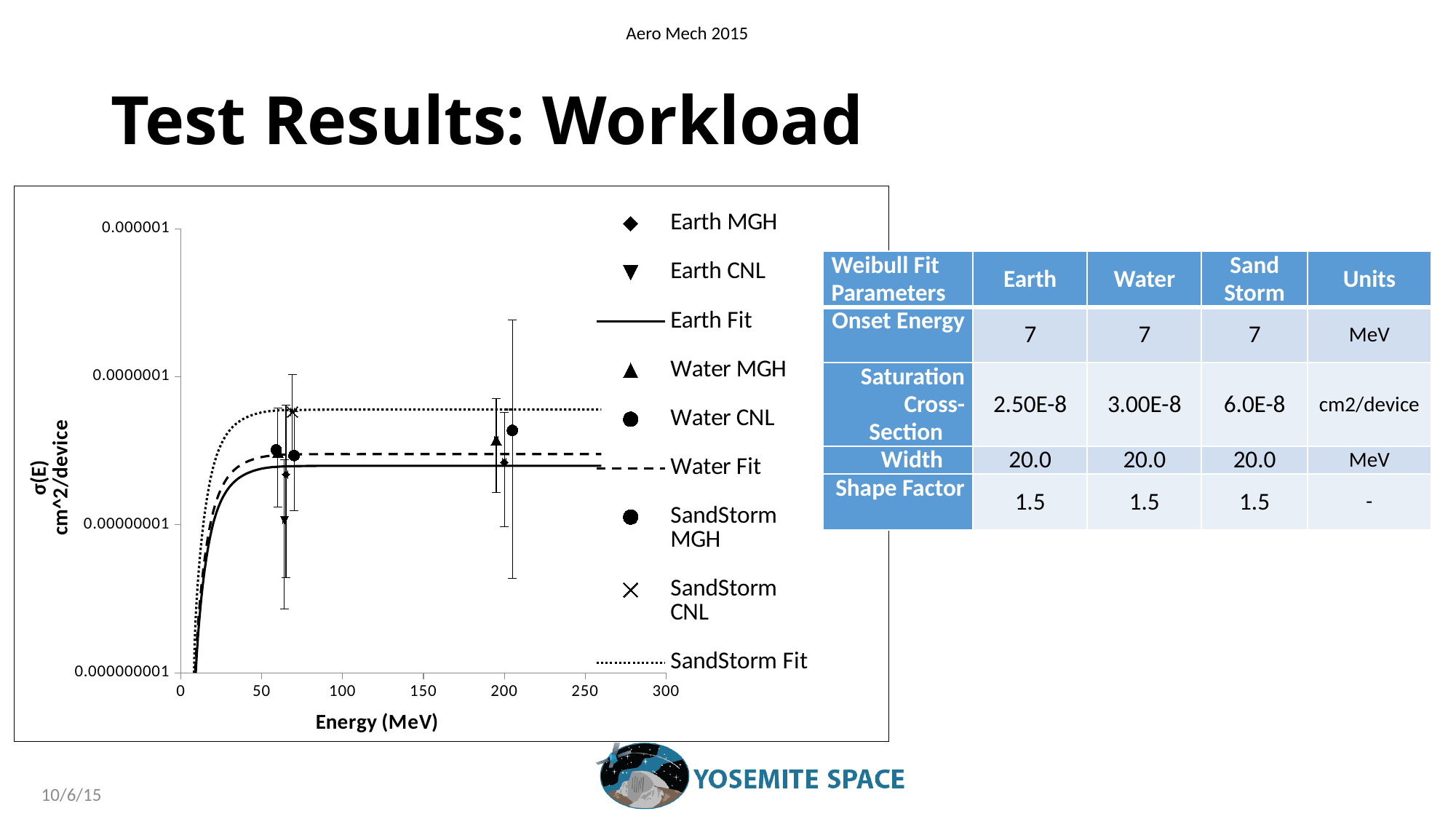
What is the title of the chart's x axis? Energy (MeV) Do the fit curves rise or fall as energy increases from 0 to 50 MeV? rise Which fit line plateaus at a higher value, Water Fit or Earth Fit? Water Fit Which fit line plateaus at the lowest value? Earth Fit Which fit line plateaus at a higher value, SandStorm Fit or Earth Fit? SandStorm Fit Is the plateau value of the SandStorm Fit line greater or less than 0.0000001? less How many series does the chart legend list? 9 How many fit lines are plotted on the chart? 3 Which legend series is drawn with a dotted line? SandStorm Fit What kind of chart is shown on the slide? scatter chart Is the plateau value of the Earth Fit line greater or less than 0.00000001? greater